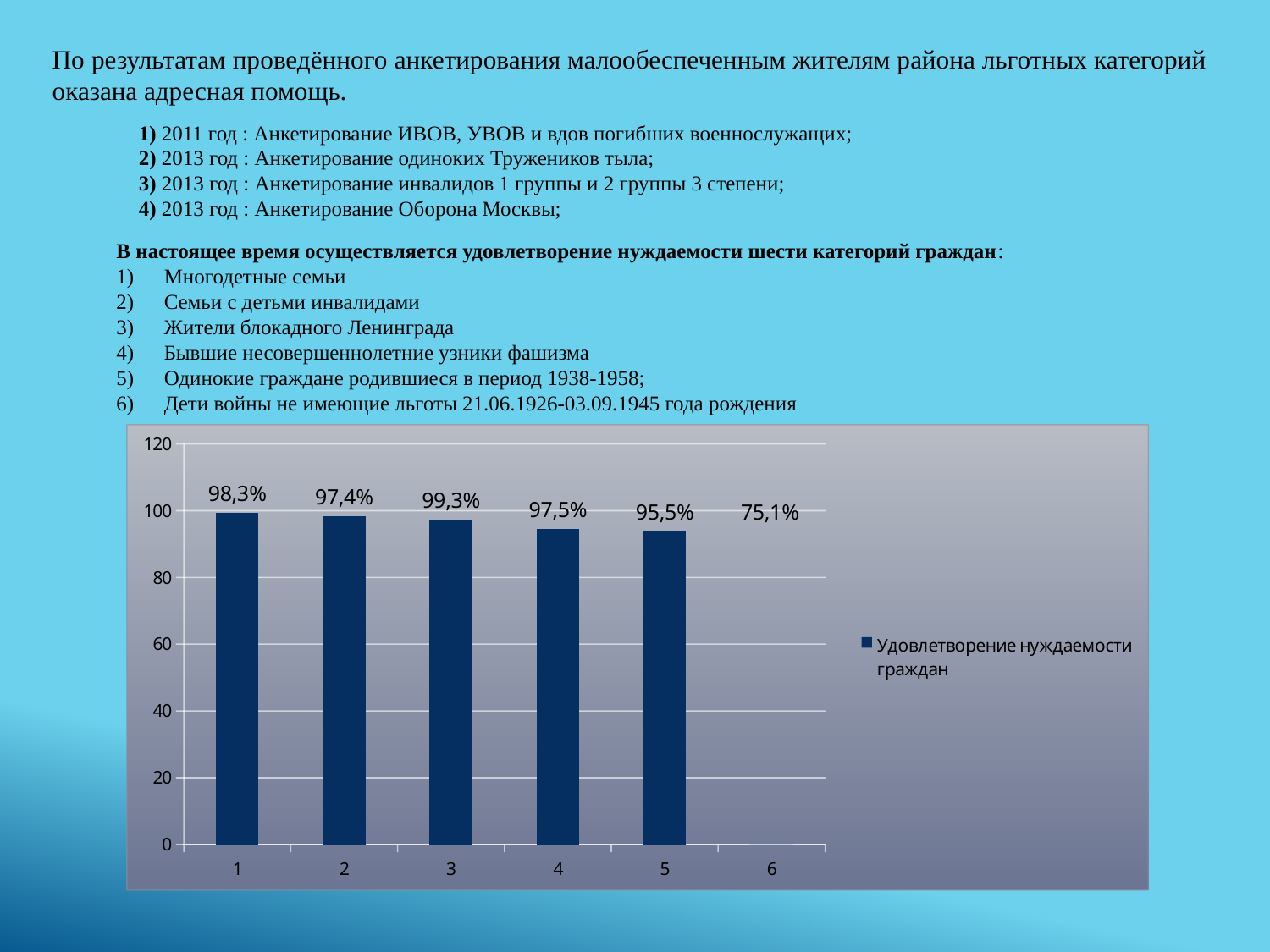
What is the value for category 6? 75,1% Which is larger, the value for category 4 or the value for category 5? category 4 What kind of chart is shown on the slide? bar chart What is the name of the series listed in the legend? Удовлетворение нуждаемости граждан How many categories are shown on the x axis? 6 What is the value for category 3? 99,3% Which category has the lowest value? 6 What is the difference between the values for category 3 and category 6? 24,2% Is the value for category 5 greater or less than 80? greater What is the value for category 5? 95,5% What is the difference between the values for category 1 and category 2? 0,9%